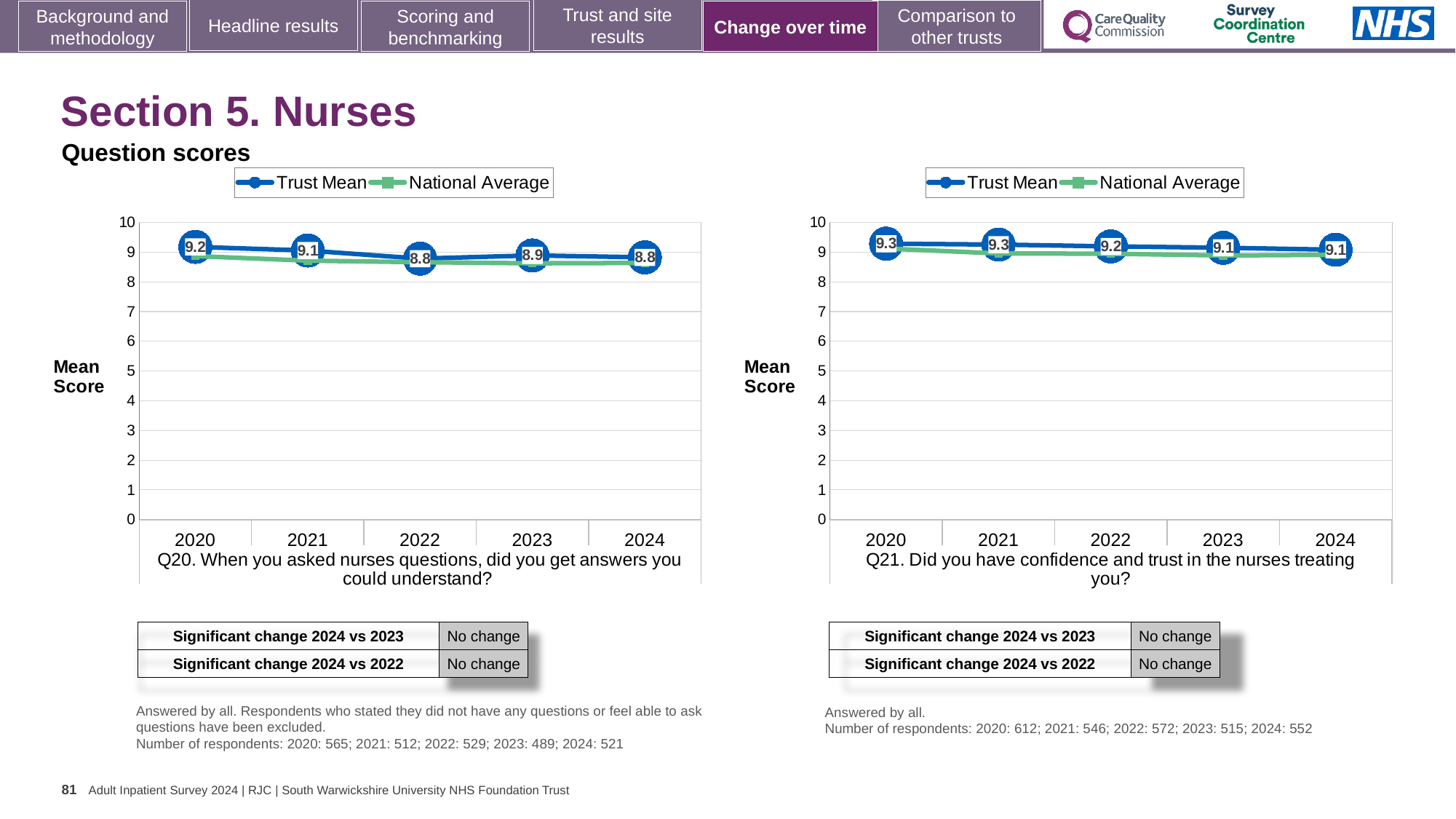
On the Q21 chart, what is the Trust Mean score for 2022? 9.2 How many series does the legend of the Q21 chart list? 2 What type of chart is used for Q21? Line chart How many years are plotted on the Q20 chart? 5 On the Q20 chart, what is the Trust Mean score for 2020? 9.2 On the Q21 chart, what is the Trust Mean score for 2024? 9.1 On the Q20 chart, what is the difference between the Trust Mean scores for 2020 and 2024? 0.4 On the Q20 chart, is the Trust Mean score higher in 2020 or in 2022? 2020 On the Q21 chart, what is the difference between the Trust Mean scores for 2020 and 2024? 0.2 On the Q20 chart, which year has the highest Trust Mean score? 2020 On the Q20 chart, what is the Trust Mean score for 2022? 8.8 On the Q21 chart, is the National Average value for 2024 greater or less than 8? greater